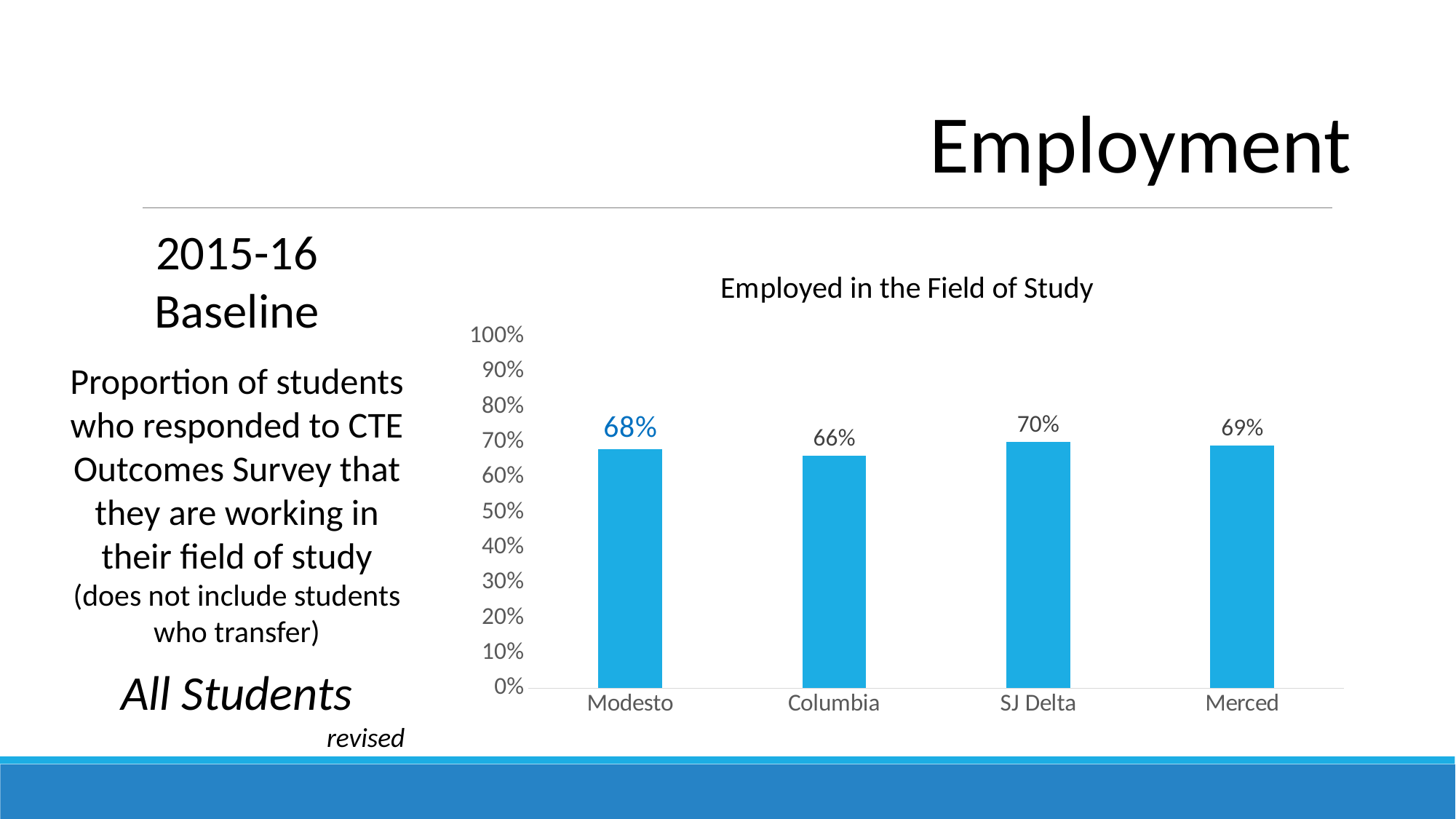
What is the value for Modesto? 68% What is the value for Columbia? 66% What kind of chart is shown on the slide? Bar chart What is the value for Merced? 69% How many colleges are shown on the chart? 4 What is the title of the chart? Employed in the Field of Study What is the value for SJ Delta? 70% What is the difference between the values for SJ Delta and Columbia? 4% Which college has the lowest value? Columbia What is the difference between the values for Merced and Modesto? 1% Which is larger, the value for Modesto or the value for Columbia? Modesto Which college has the highest value? SJ Delta